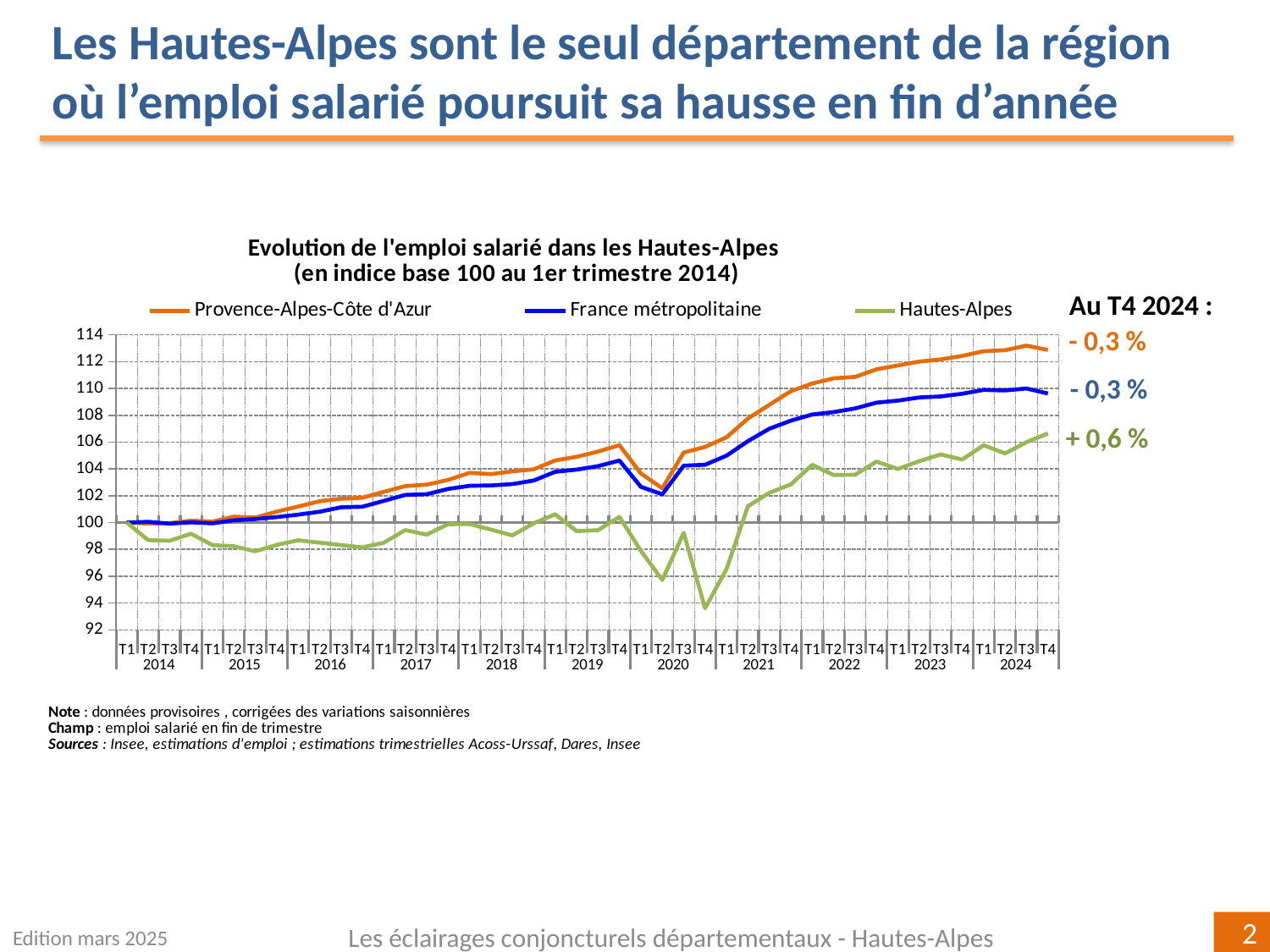
Is the value for Provence-Alpes-Côte d'Azur at T4 2024 greater or less than 112? greater What change is annotated for Hautes-Alpes at T4 2024? + 0,6 % How many series does the chart legend list? 3 Which series is highest at T4 2024? Provence-Alpes-Côte d'Azur What kind of chart is shown on the slide? line chart What change is annotated for France métropolitaine at T4 2024? - 0,3 % How many years are shown along the x axis? 11 At T4 2020, which is higher: France métropolitaine or Hautes-Alpes? France métropolitaine Which series is lowest at T4 2020? Hautes-Alpes Does the Provence-Alpes-Côte d'Azur series rise or fall overall from 2014 to 2024? rise Is the value for Hautes-Alpes at T4 2020 greater or less than 96? less Is the value for Hautes-Alpes at T4 2024 greater or less than 104? greater